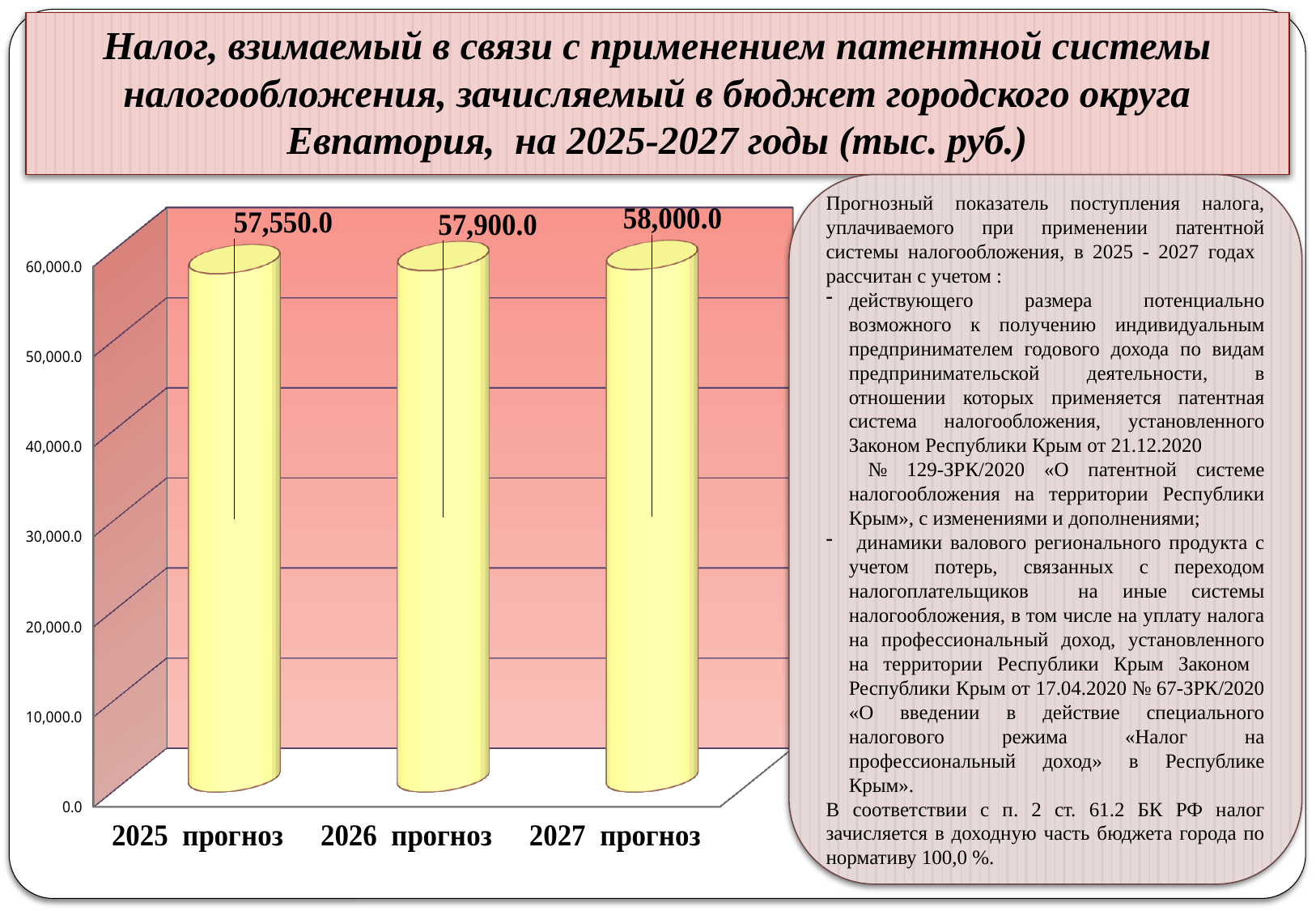
What is the value for 2026 прогноз? 57,900.0 What is the value for 2025 прогноз? 57,550.0 Which category has the lowest value? 2025 прогноз What is the difference between the values for 2027 прогноз and 2025 прогноз? 450.0 Is the value for 2025 прогноз greater or less than 50,000.0? greater What is the difference between the values for 2026 прогноз and 2025 прогноз? 350.0 What is the value for 2027 прогноз? 58,000.0 Which category has the highest value? 2027 прогноз Do the values rise or fall from 2025 прогноз to 2027 прогноз? rise Which is larger, the value for 2026 прогноз or the value for 2027 прогноз? 2027 прогноз How many categories are shown on the x axis? 3 What kind of chart is shown on the slide? bar chart